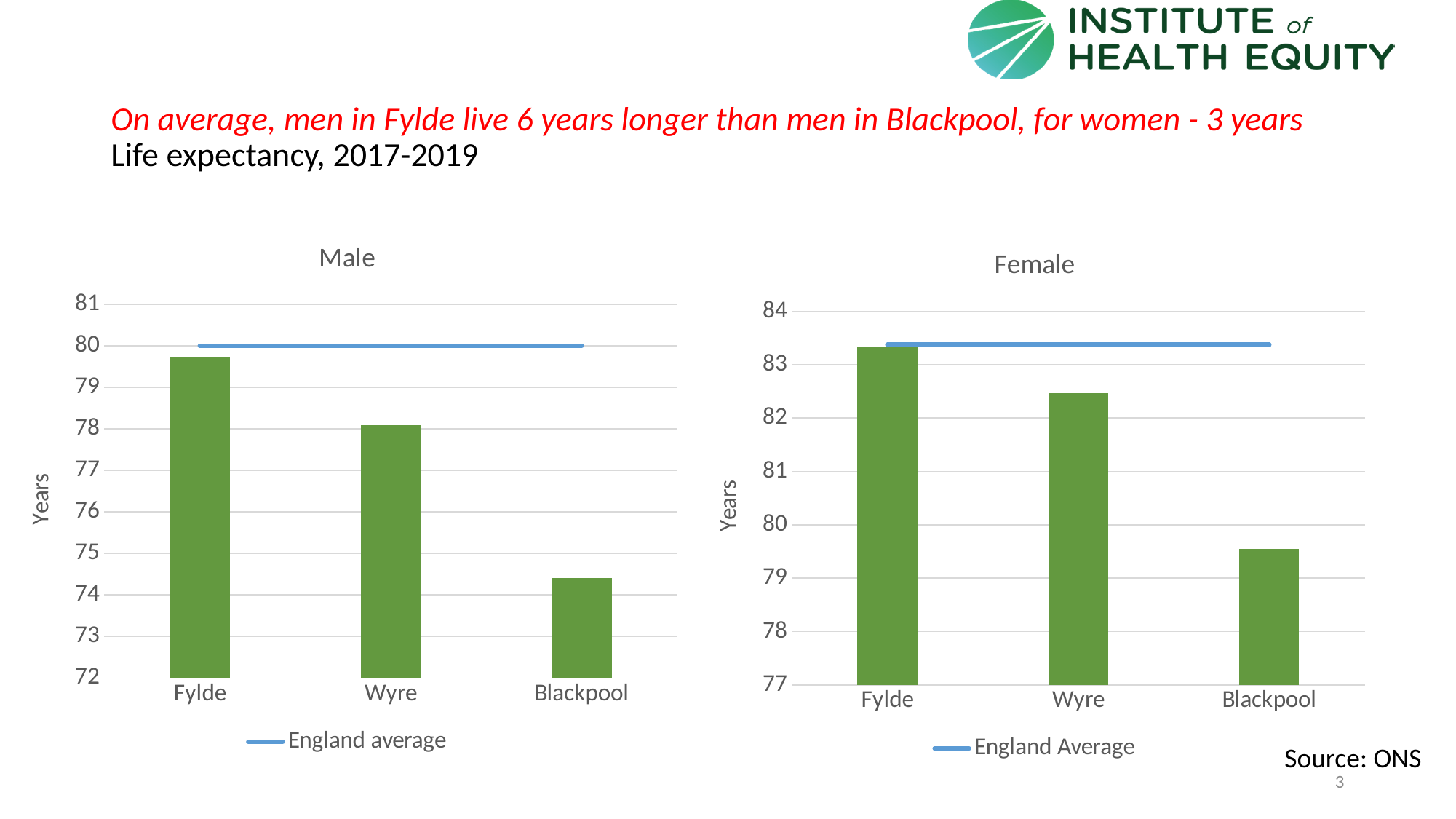
In the Male chart, is the value for Fylde greater or less than 80? less In the Male chart, how many areas are shown on the x axis? 3 In the Male chart, what does the blue horizontal line represent according to the legend? England average In the Female chart, which is larger, the value for Fylde or the value for Wyre? Fylde In the Female chart, is the value for Blackpool greater or less than 80? less In the Male chart, what kind of chart is used to show life expectancy? bar chart In the Female chart, is the value for Wyre greater or less than 82? greater In the Male chart, which area has the highest life expectancy? Fylde In the Male chart, which area has the lowest life expectancy? Blackpool In the Female chart, do the bar values rise or fall from Fylde to Blackpool? fall In the Female chart, which area has the lowest life expectancy? Blackpool